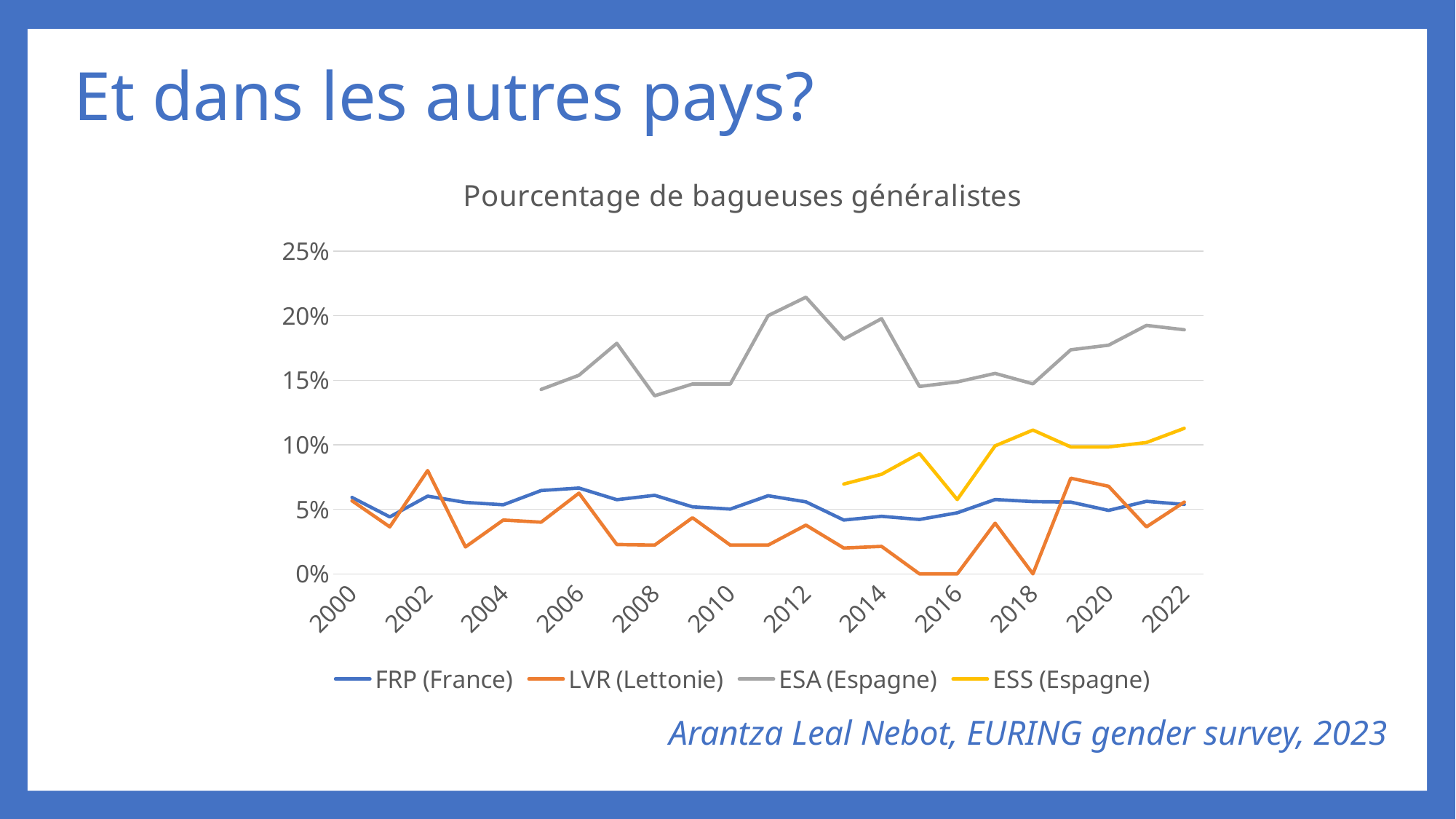
Which series has the lowest value in 2016? LVR (Lettonie) In 2012, which is larger: ESA (Espagne) or FRP (France)? ESA (Espagne) How many series does the legend list? 4 Does the ESS (Espagne) series rise or fall from 2016 to 2022? rise Is the value for ESS (Espagne) in 2022 greater or less than 10%? greater Which series has the highest values across the chart? ESA (Espagne) Is the value for ESA (Espagne) in 2012 greater or less than 20%? greater What is the title of the chart? Pourcentage de bagueuses généralistes What kind of chart is shown on the slide? line chart Is the value for LVR (Lettonie) in 2016 greater or less than 5%? less Which series is drawn in grey? ESA (Espagne)